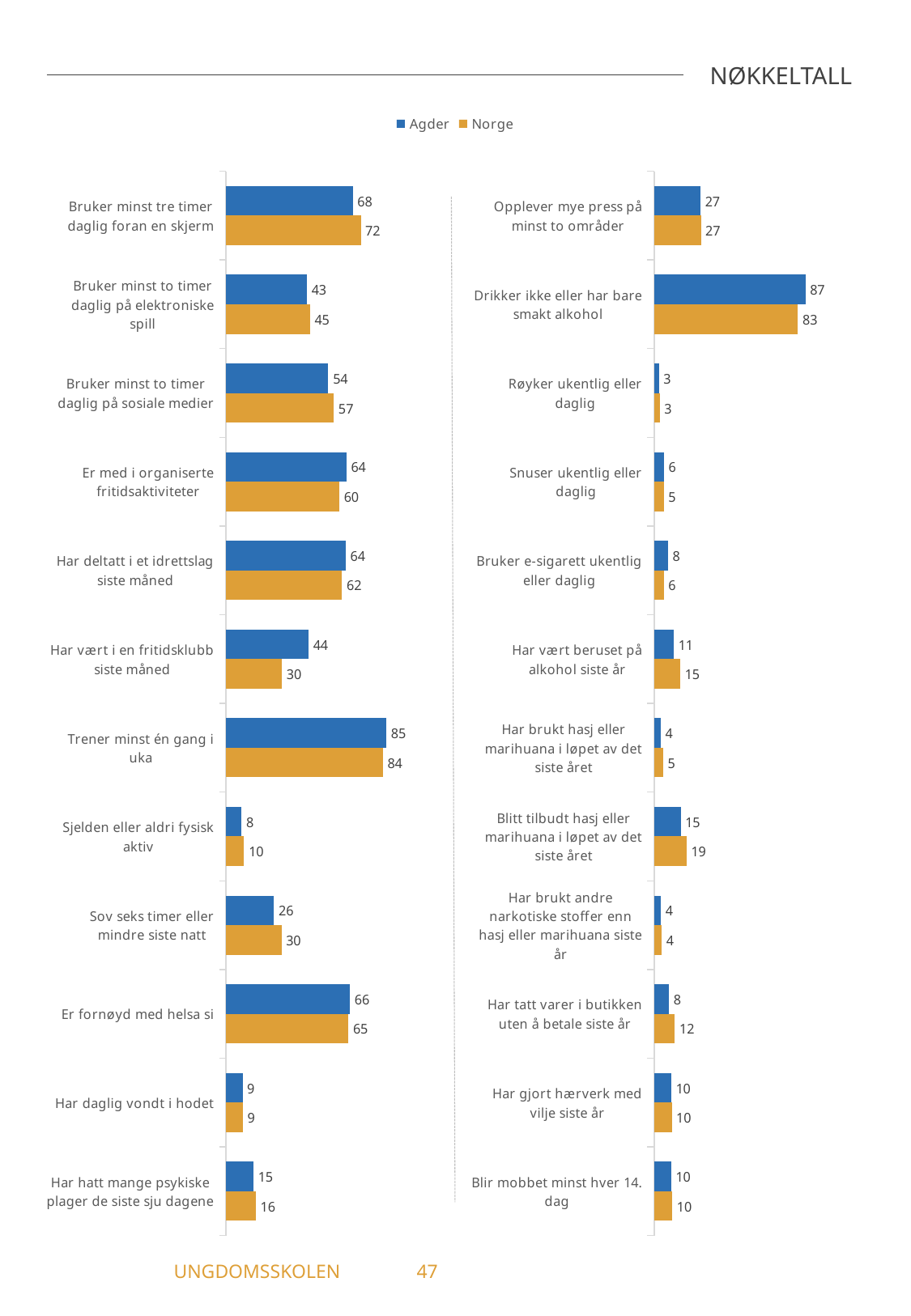
How many categories does the left chart show? 12 How many series does the legend list? 2 In the right chart, which is larger for 'Har vært beruset på alkohol siste år': Agder or Norge? Norge In the right chart, what is the Norge value for 'Blitt tilbudt hasj eller marihuana i løpet av det siste året'? 19 What kind of chart is used on this slide? Bar chart In the left chart, what is the Agder value for 'Har vært i en fritidsklubb siste måned'? 44 In the left chart, what is the difference between the Norge and Agder values for 'Har vært i en fritidsklubb siste måned'? 14 In the left chart, which is larger for 'Sov seks timer eller mindre siste natt': Agder or Norge? Norge Which series is shown in orange in the legend? Norge In the right chart, which category has the lowest Norge value? Røyker ukentlig eller daglig In the right chart, what is the difference between the Agder and Norge values for 'Drikker ikke eller har bare smakt alkohol'? 4 In the left chart, which category has the highest Agder value? Trener minst én gang i uka